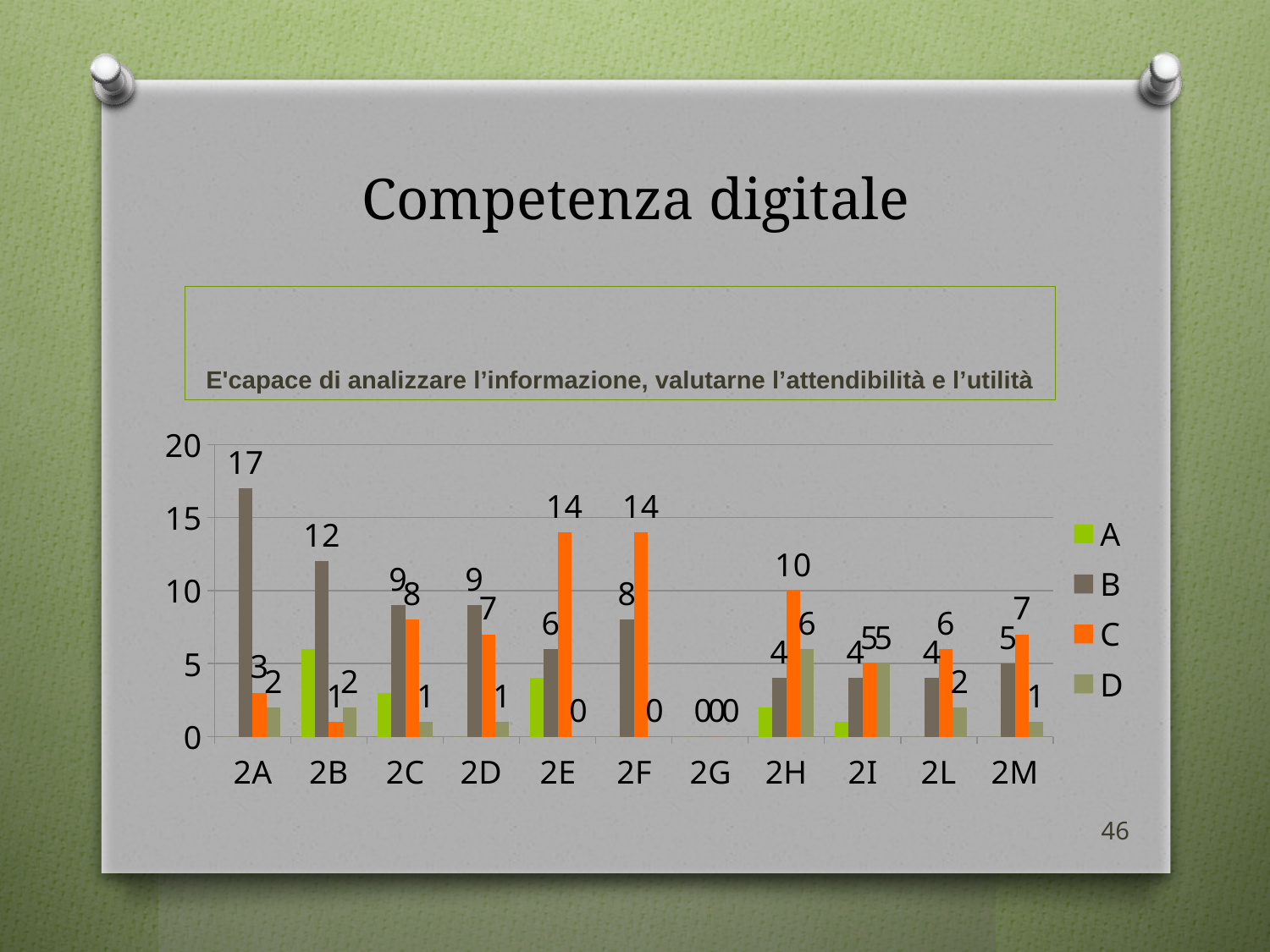
What is the title of the slide containing the chart? Competenza digitale What is the value of series C for 2H? 10 Which category has the highest value for series B? 2A Is the value of series A for 2H greater or less than 5? less What is the value of series D for 2H? 6 What is the difference between the series B values for 2A and 2B? 5 How many series does the legend list? 4 How many categories are shown on the x axis? 11 What kind of chart is shown on the slide? bar chart For 2C, which is larger: series B or series C? B What is the value of series B for 2A? 17 What is the value of series C for 2E? 14